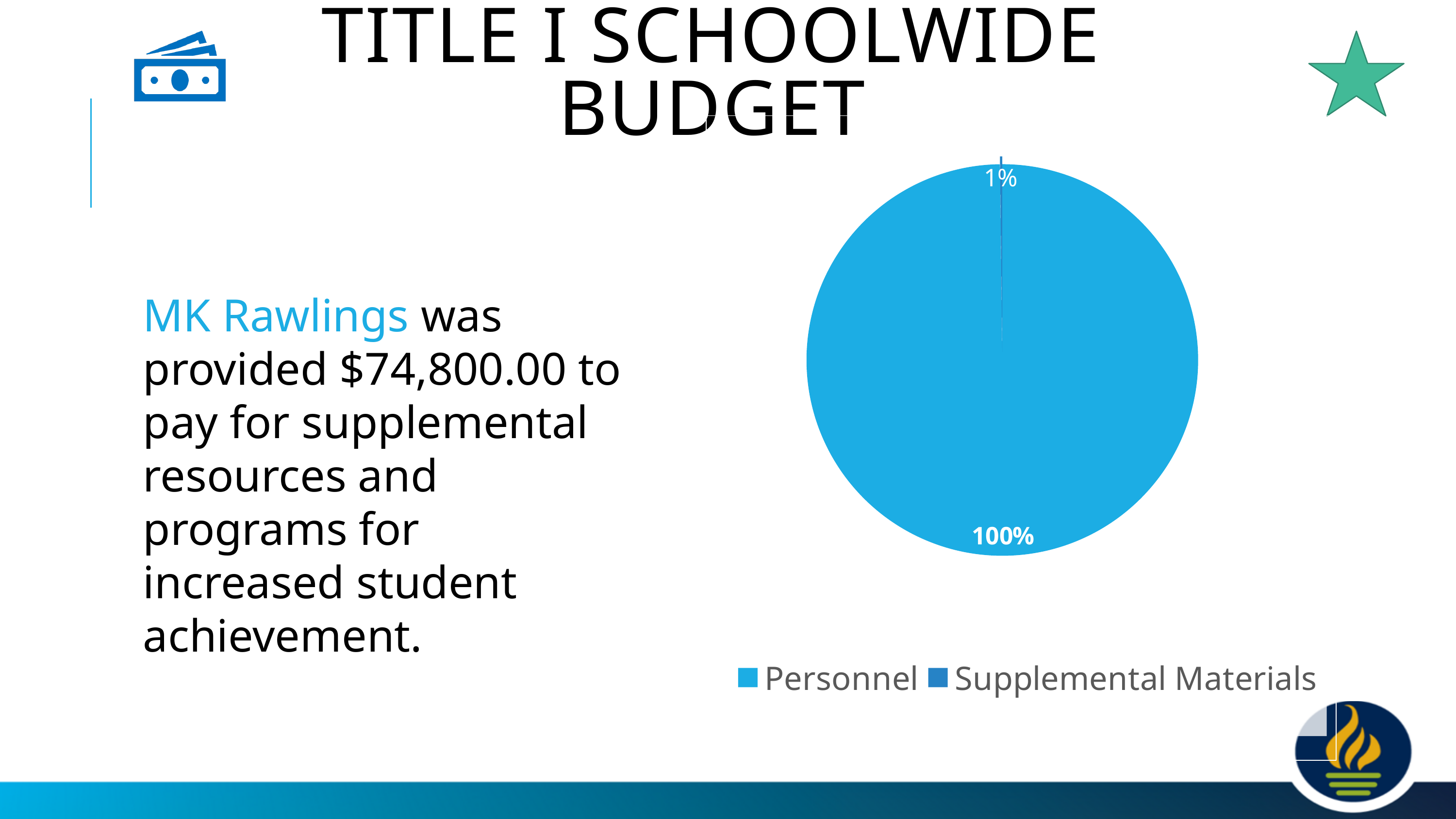
Which category has the smallest share of the pie chart? Supplemental Materials Which is larger in the pie chart, Personnel or Supplemental Materials? Personnel What are the two categories listed in the pie chart's legend? Personnel and Supplemental Materials How many slices does the pie chart have? 2 What share of the pie does the Personnel slice represent according to its label? 100% How many entries does the legend of the pie chart list? 2 Which category has the largest share of the pie chart? Personnel What kind of chart is shown on the slide? pie chart What percentage is shown for Supplemental Materials in the pie chart? 1% What percentage is shown for Personnel in the pie chart? 100% What is the title of the slide containing the pie chart? TITLE I SCHOOLWIDE BUDGET What is the difference between the percentage labels for Personnel and Supplemental Materials? 99%